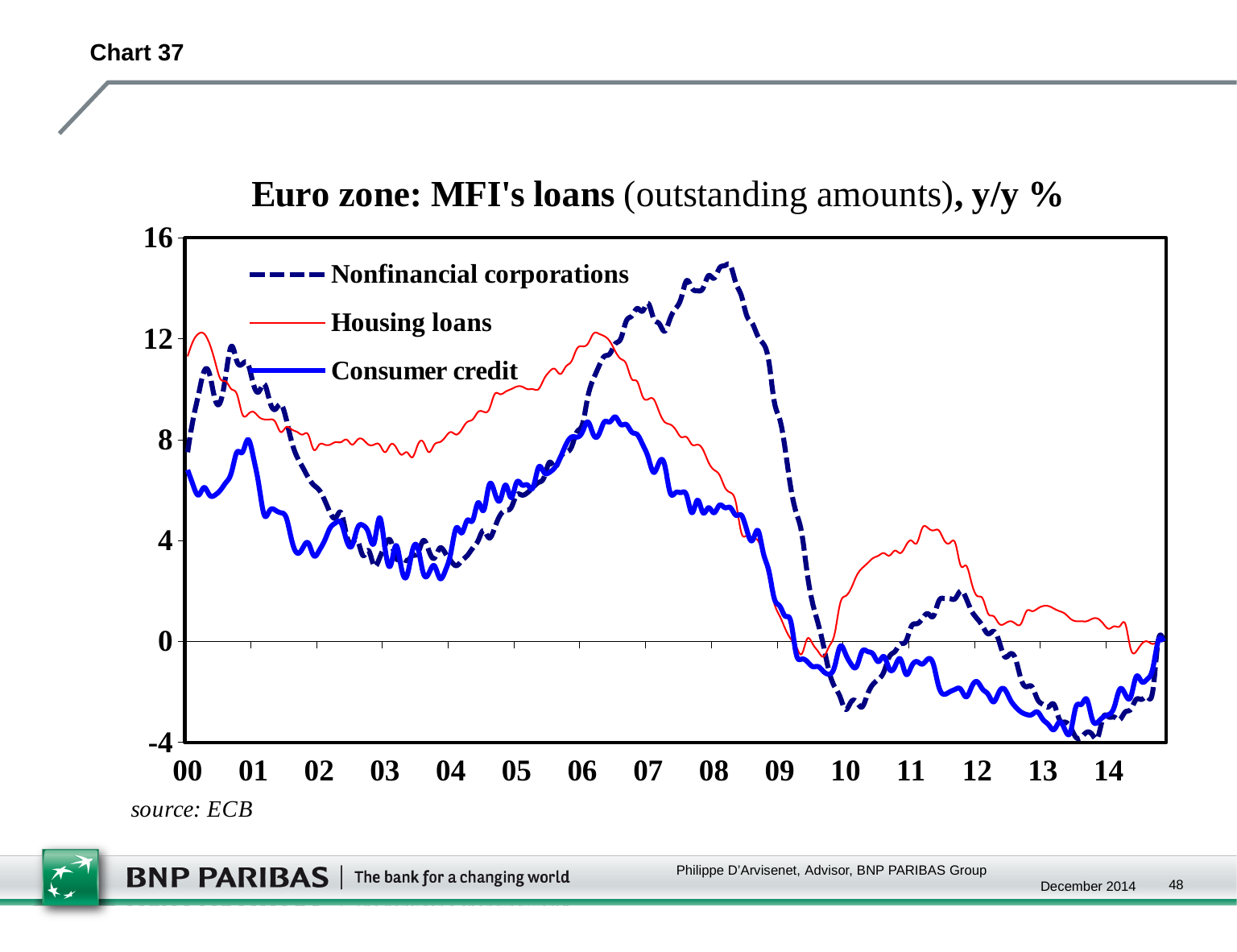
Which series is drawn as a dashed line? Nonfinancial corporations Is the peak value for Nonfinancial corporations around 2008 greater or less than 12? greater What is the title of the chart? Euro zone: MFI's loans (outstanding amounts), y/y % Is the peak value for Housing loans around 2011 greater or less than 8? less In 2011, which series is higher, Housing loans or Consumer credit? Housing loans Is the value for Consumer credit in 2013 greater or less than 0? less In 2008, which series is higher, Nonfinancial corporations or Consumer credit? Nonfinancial corporations What kind of chart is shown on the slide? line chart How many year labels are shown on the x axis? 15 Which series reaches the highest value anywhere on the chart? Nonfinancial corporations How many series does the legend list? 3 Do the values for Nonfinancial corporations rise or fall between 2008 and 2010? fall